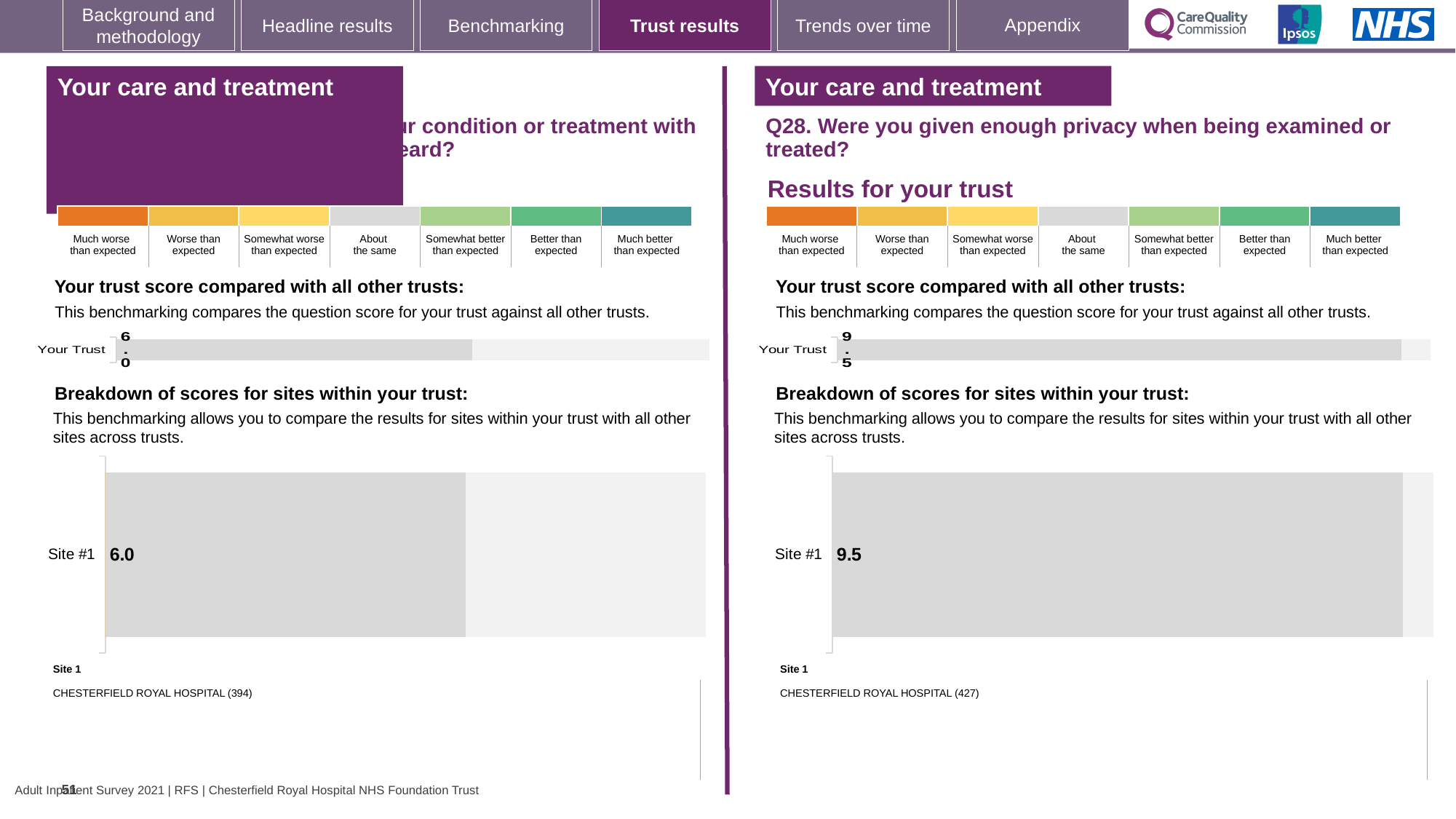
Which is larger: the Your Trust score in the left-hand chart or the Your Trust score in the right-hand chart (Q28)? The right-hand chart (Q28) On the left-hand side of the slide, what is the score shown for Your Trust in the 'Your trust score compared with all other trusts' chart? 6.0 Which hospital is listed as Site 1 beneath the right-hand breakdown chart (Q28)? CHESTERFIELD ROYAL HOSPITAL (427) How many sites are shown in the right-hand 'Breakdown of scores for sites within your trust' chart (Q28)? 1 In the left-hand 'Breakdown of scores for sites within your trust' chart, what is the score for Site #1? 6.0 On the right-hand side of the slide (Q28), what is the score shown for Your Trust in the 'Your trust score compared with all other trusts' chart? 9.5 How many sites are shown in the left-hand 'Breakdown of scores for sites within your trust' chart? 1 Which hospital is listed as Site 1 beneath the left-hand breakdown chart? CHESTERFIELD ROYAL HOSPITAL (394) What is the difference between the Site #1 score in the right-hand breakdown chart (Q28) and the Site #1 score in the left-hand breakdown chart? 3.5 In the right-hand 'Breakdown of scores for sites within your trust' chart (Q28), what is the score for Site #1? 9.5 What type of chart is used to show the Site #1 score in the right-hand breakdown chart (Q28)? Bar chart